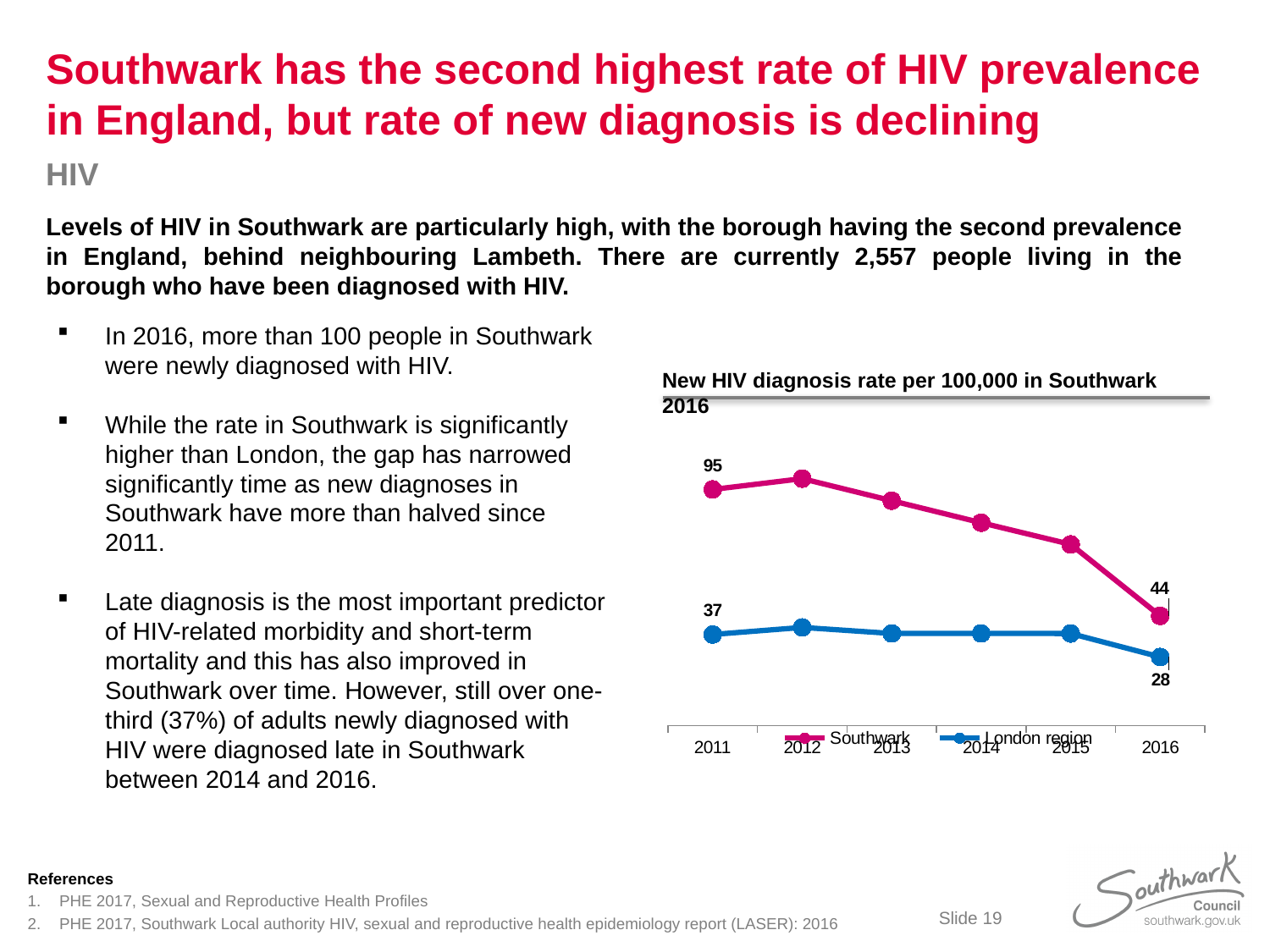
What was the new HIV diagnosis rate per 100,000 for Southwark in 2016? 44 By how much did the Southwark rate fall between 2011 and 2016? 51 Which two series are shown in the chart legend? Southwark and London region What type of chart is shown on the slide? line chart What is the difference between the Southwark and London region rates in 2016? 16 What was the new HIV diagnosis rate per 100,000 for the London region in 2011? 37 How many series does the chart legend list? 2 What was the new HIV diagnosis rate per 100,000 for Southwark in 2011? 95 How many years are plotted along the x axis of the chart? 6 Which series has the higher value in 2016, Southwark or London region? Southwark What was the new HIV diagnosis rate per 100,000 for the London region in 2016? 28 What is the title of the chart? New HIV diagnosis rate per 100,000 in Southwark 2016